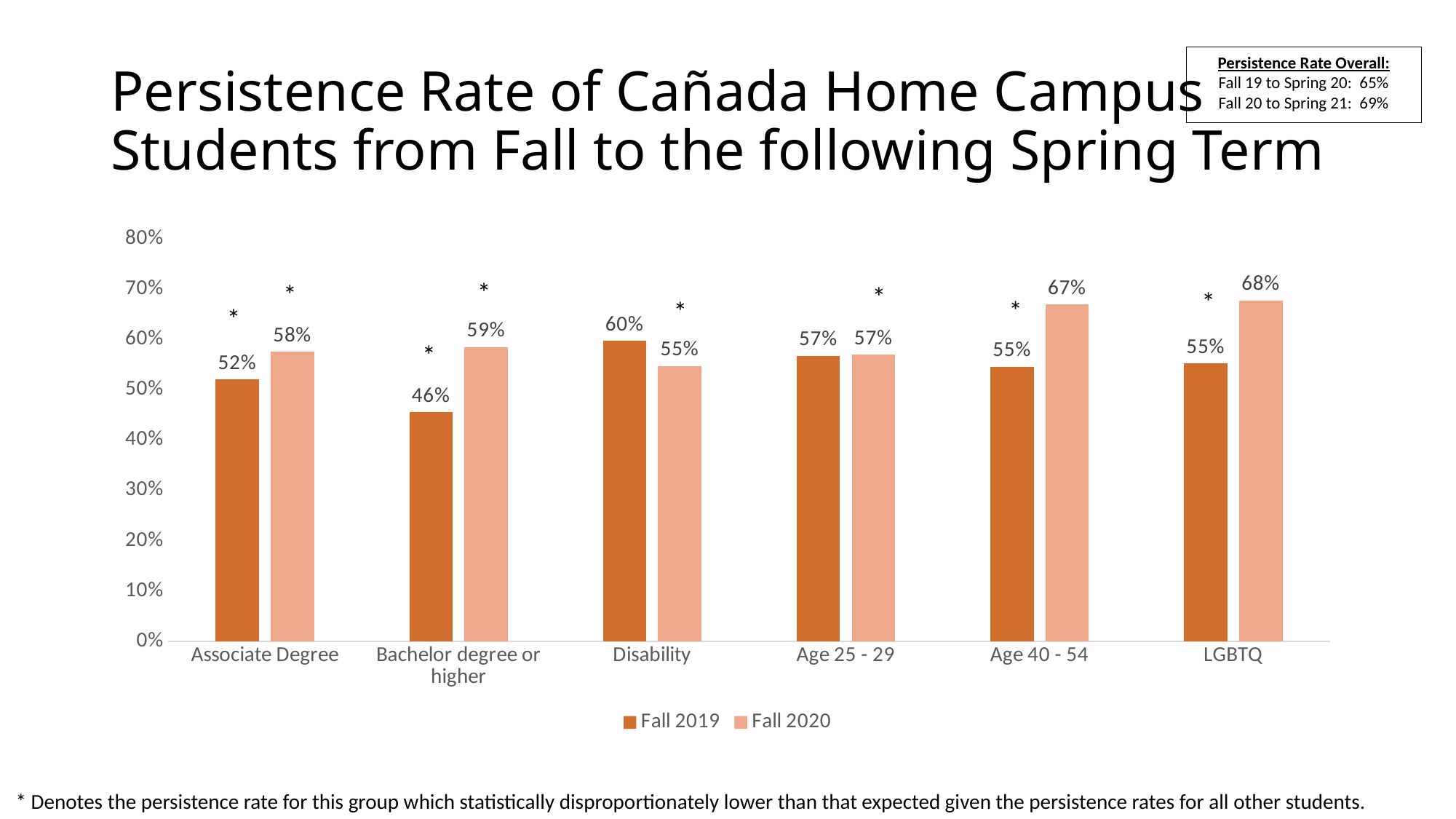
How many categories are shown on the x axis of the chart? 6 What is the Fall 2019 persistence rate for Associate Degree students? 52% Which category has the lowest Fall 2019 persistence rate? Bachelor degree or higher What is the Fall 2020 persistence rate for LGBTQ students? 68% What is the Fall 2019 persistence rate for Bachelor degree or higher students? 46% What is the difference between the Fall 2020 and Fall 2019 persistence rates for Bachelor degree or higher students? 13% How many series does the legend list? 2 Which category has the highest Fall 2020 persistence rate? LGBTQ What is the Fall 2020 persistence rate for Age 40 - 54 students? 67% Which category has the highest Fall 2019 persistence rate? Disability What kind of chart is shown on the slide? Bar chart For the Disability group, which is larger: the Fall 2019 or the Fall 2020 persistence rate? Fall 2019